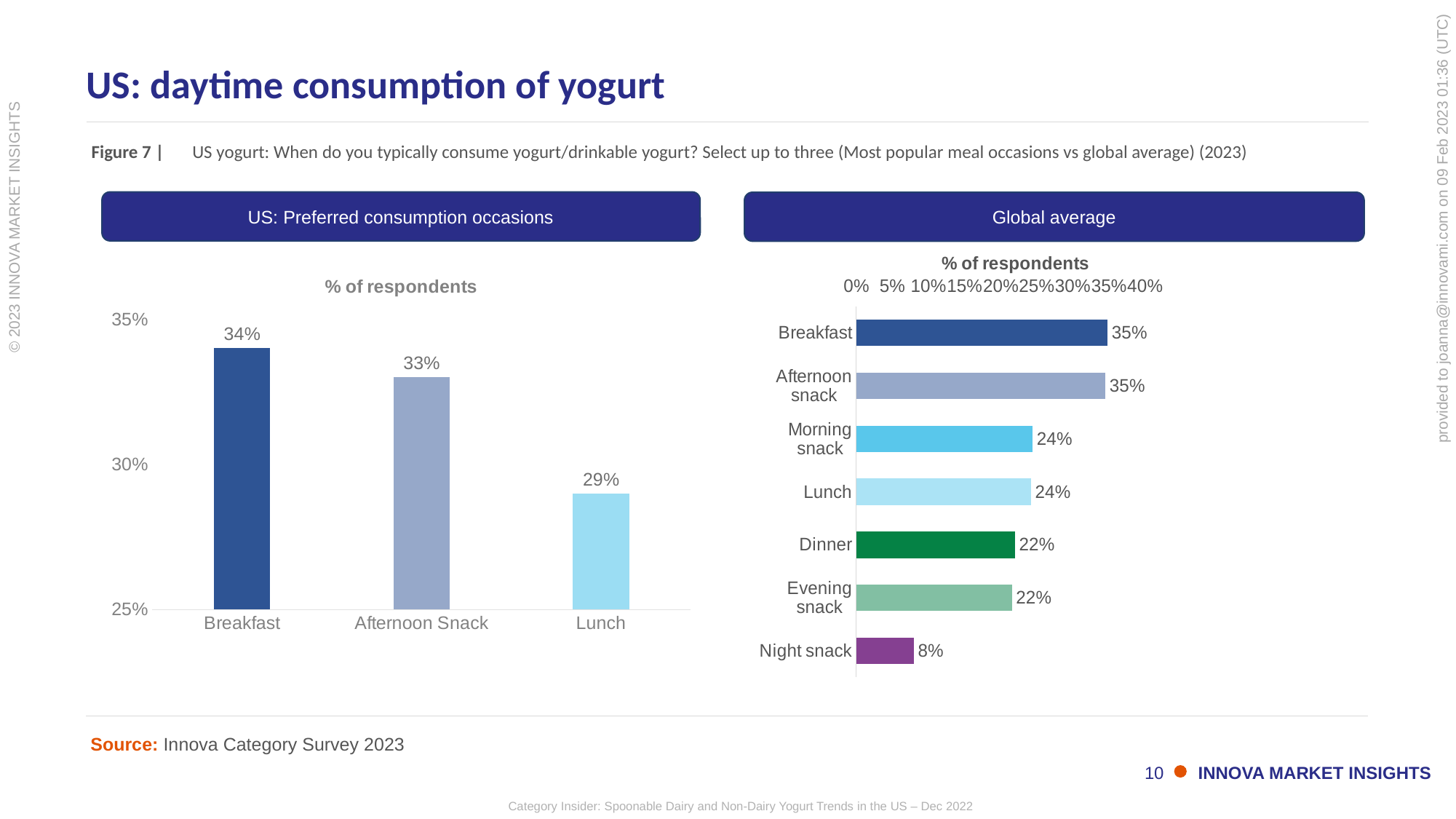
In the 'Global average' chart, which category has the lowest value? Night snack In the 'Global average' chart, what is the value for Dinner? 22% In the 'US: Preferred consumption occasions' chart, which category has the lowest value? Lunch What kind of chart is the 'Global average' chart? Bar chart In the 'Global average' chart, what is the difference between Breakfast and Night snack? 27% In the 'US: Preferred consumption occasions' chart, what is the value for Breakfast? 34% In the 'US: Preferred consumption occasions' chart, how many categories are shown? 3 In the 'US: Preferred consumption occasions' chart, what is the difference between Breakfast and Lunch? 5% In the 'Global average' chart, which is larger: Morning snack or Evening snack? Morning snack In the 'US: Preferred consumption occasions' chart, what is the value for Lunch? 29% In the 'Global average' chart, what is the value for Night snack? 8% In the 'Global average' chart, how many categories are shown? 7